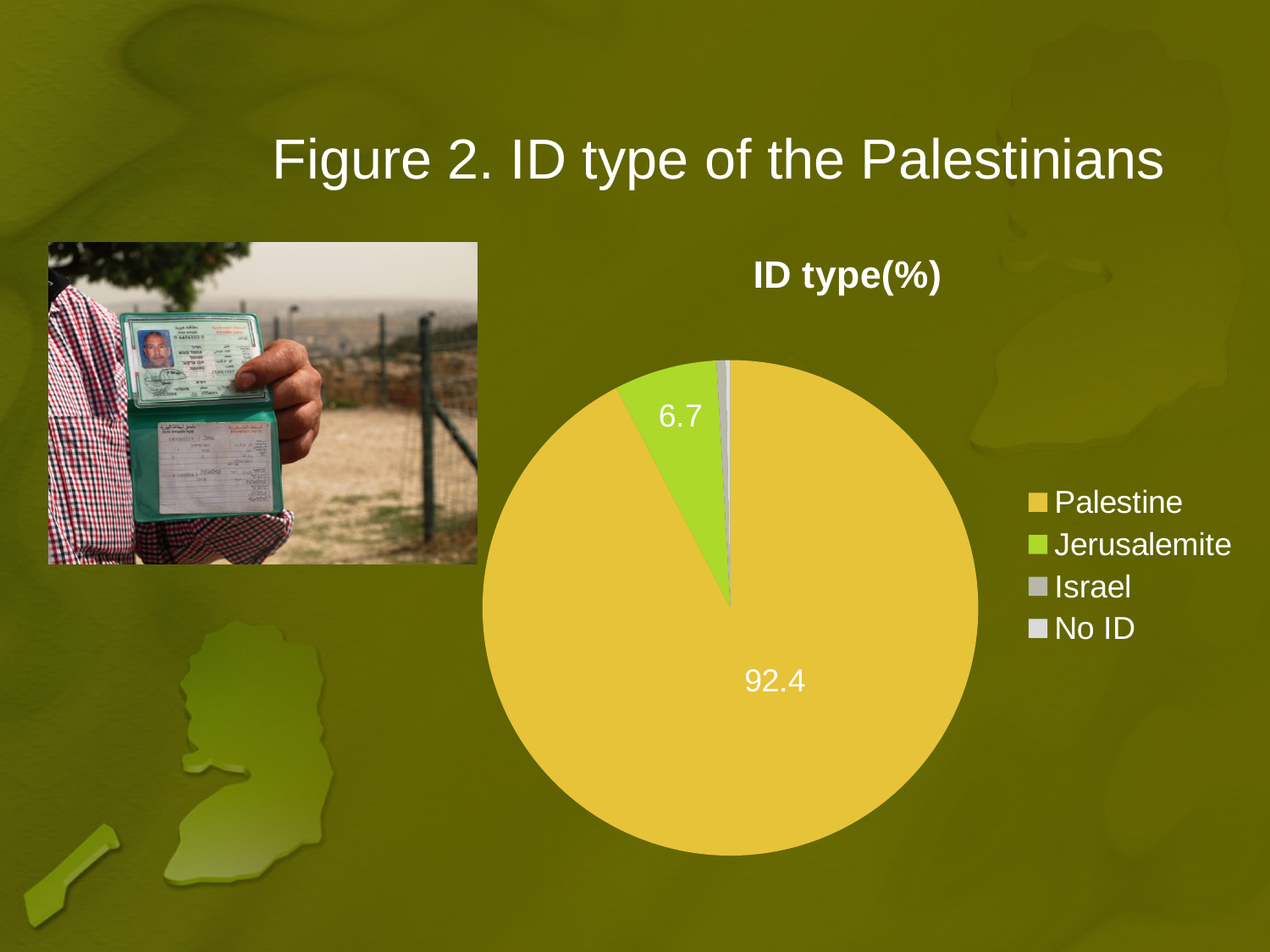
What is the title of the chart? ID type(%) What is the difference between the values for Palestine and Jerusalemite? 85.7 Which is larger, the value for Palestine or the value for Jerusalemite? Palestine Which is larger, the slice for Jerusalemite or the slice for Israel? Jerusalemite What type of chart is shown on the slide? pie chart What is the value for Jerusalemite? 6.7 Which category has the largest slice of the pie? Palestine How many categories does the legend list? 4 Which category is shown in green in the legend? Jerusalemite What is the value for Palestine? 92.4